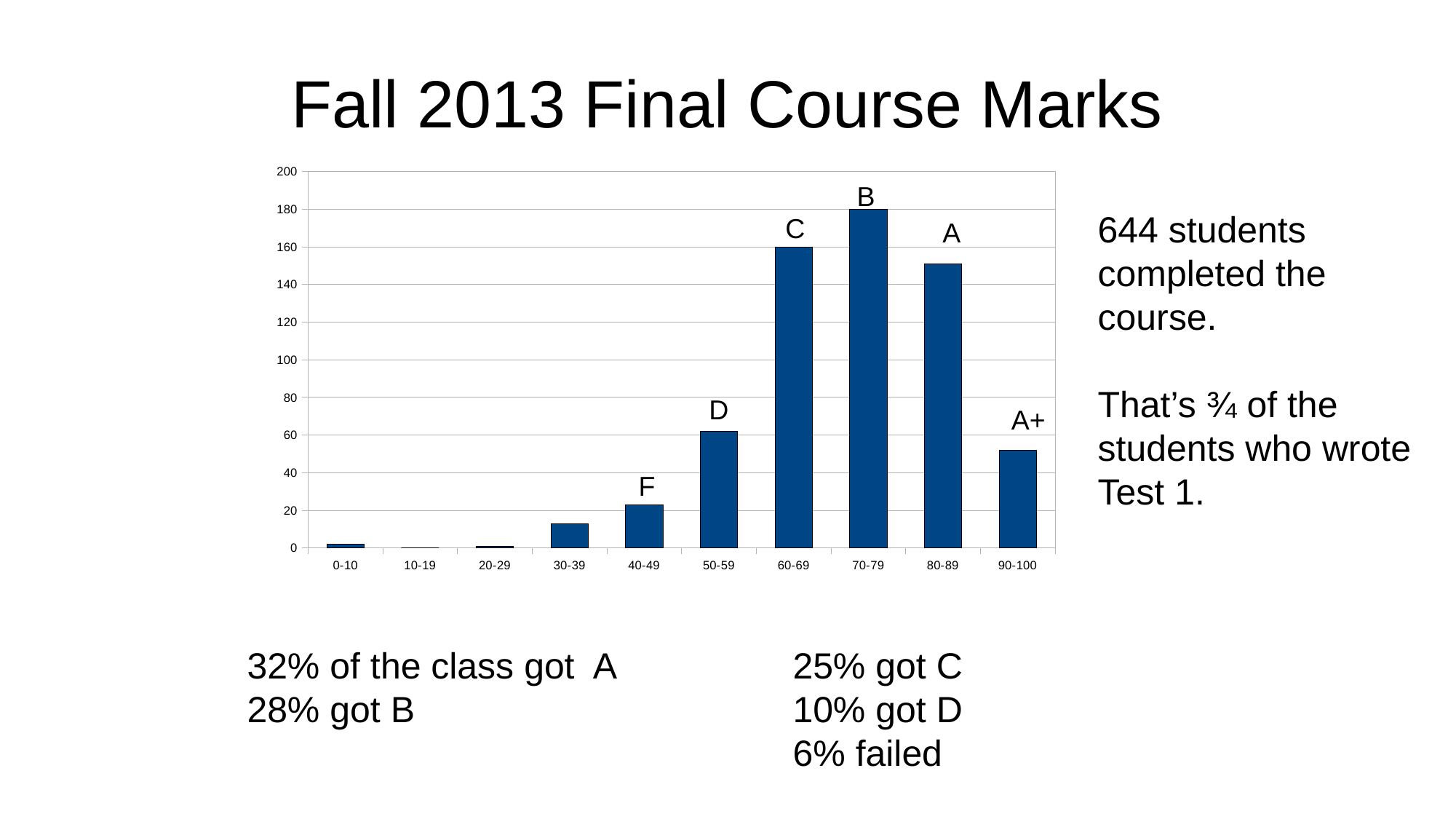
What kind of chart is shown on the slide? bar chart Which is larger, the value for 60-69 or the value for 80-89? 60-69 Is the value for the 50-59 mark range greater or less than 80? less What is the value for the 70-79 mark range? 180 Is the value for the 80-89 mark range greater or less than 140? greater Which mark range has the lowest bar? 10-19 Which letter grade label is placed above the 90-100 bar? A+ How many mark ranges (categories) are shown on the x axis? 10 Is the value for the 90-100 mark range greater or less than 40? greater What is the value for the 60-69 mark range? 160 Do the bar values rise or fall from the 0-10 range to the 70-79 range? rise Which mark range has the highest bar? 70-79